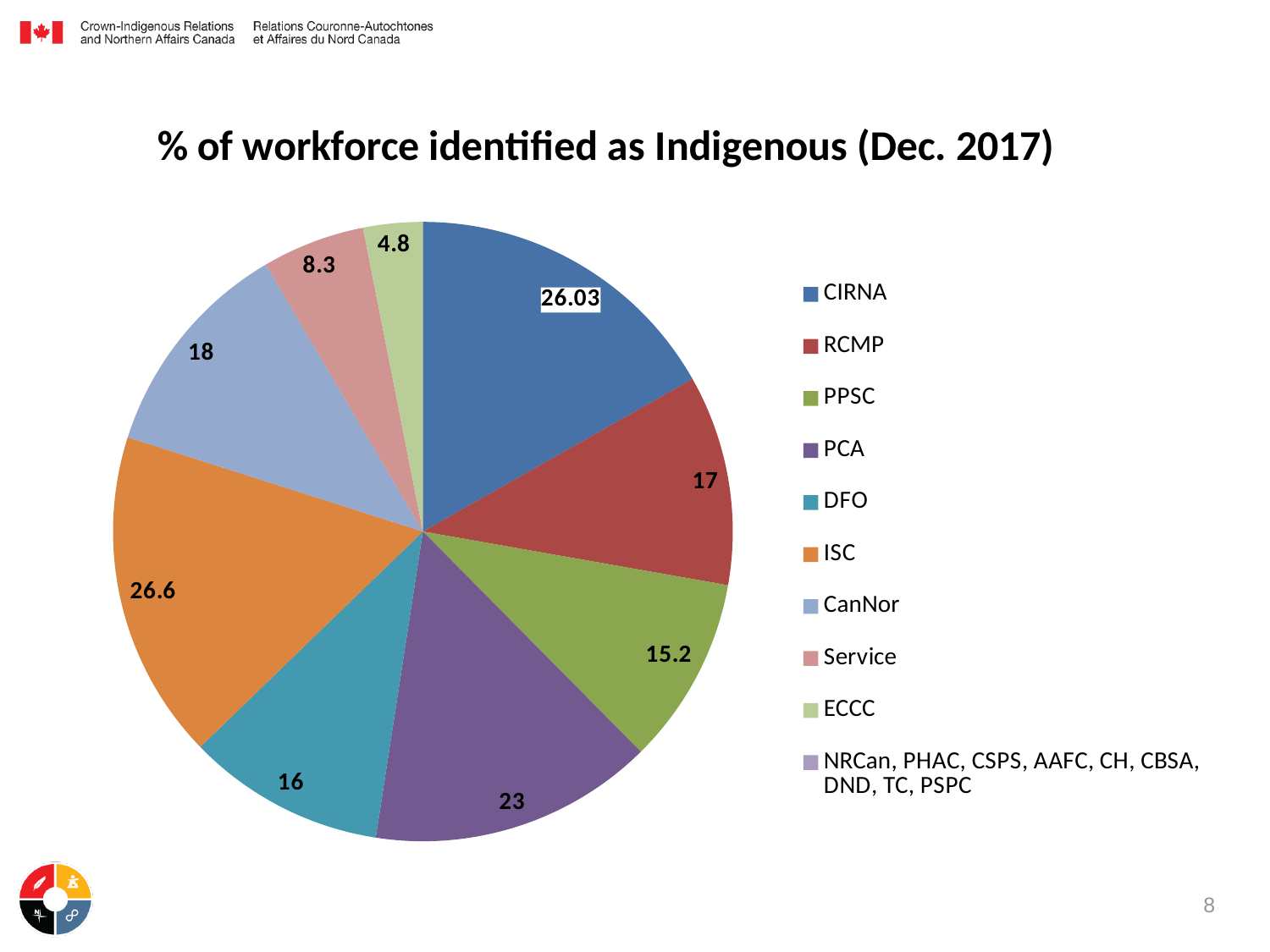
What kind of chart is shown on the slide? Pie chart What is the difference between the values for PCA and DFO? 7 Which is larger, the value for RCMP or the value for PPSC? RCMP Which category has the largest value in the pie chart? ISC What is the difference between the values for CanNor and Service? 9.7 Which category has the smallest value in the pie chart? ECCC How many entries does the legend list? 10 What value is shown for CIRNA? 26.03 What value is shown for Service? 8.3 What value is shown for PCA? 23 What value is shown for ISC? 26.6 What is the title of the chart? % of workforce identified as Indigenous (Dec. 2017)